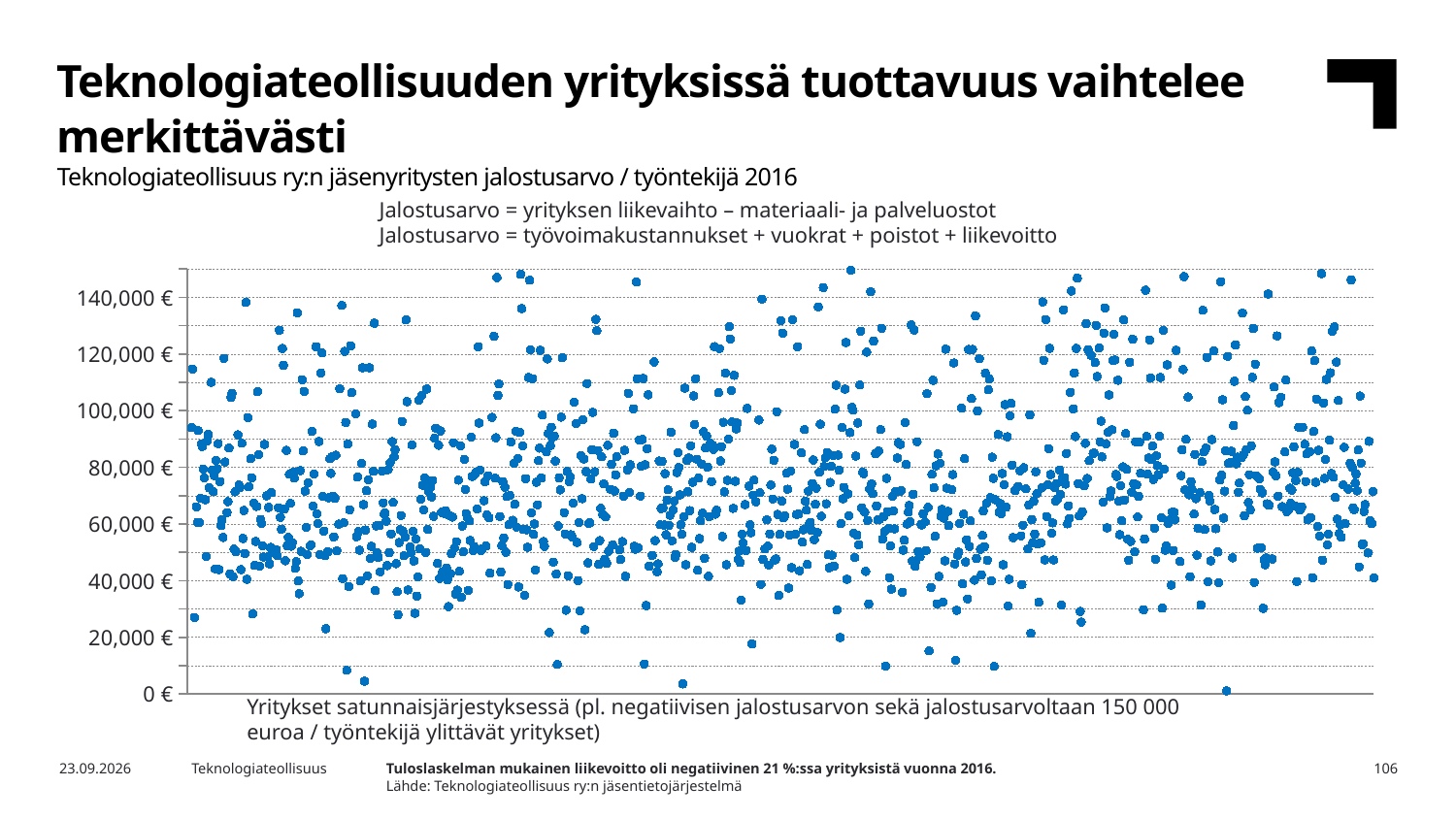
What is the highest value labelled on the vertical axis of the chart? 140,000 € What year's data does the chart show, according to its subtitle? 2016 Is the lowest plotted point greater or less than 20,000 €? less Are most of the plotted points above or below 100,000 € on the vertical axis? below Are there any plotted points above the 140,000 € gridline? yes What kind of chart is shown on the slide? scatter chart